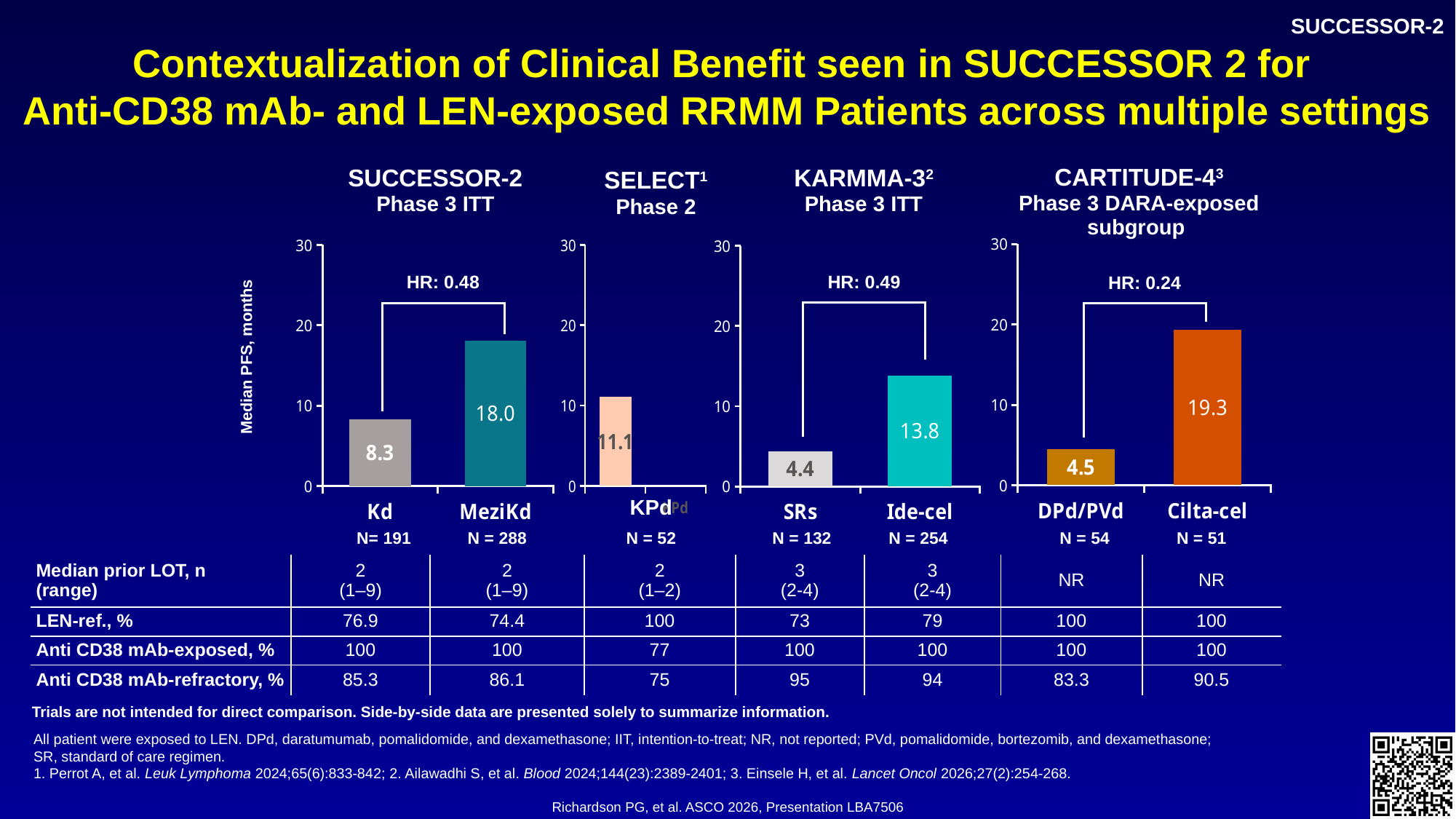
In the KARMMA-3 chart, what is the difference in median PFS between Ide-cel and SRs? 9.4 In the CARTITUDE-4 chart, what is the median PFS in months for Cilta-cel? 19.3 In the KARMMA-3 chart, which arm has the lowest median PFS? SRs How many bars are shown in the SELECT chart? 1 In the CARTITUDE-4 chart, which arm has the higher median PFS, DPd/PVd or Cilta-cel? Cilta-cel What type of chart is used to show median PFS in the SUCCESSOR-2 panel? Bar chart In the SUCCESSOR-2 chart, what is the difference in median PFS between MeziKd and Kd? 9.7 In the KARMMA-3 chart, what is the median PFS in months for Ide-cel? 13.8 In the SUCCESSOR-2 chart, what is the median PFS in months for MeziKd? 18.0 In the SUCCESSOR-2 chart, what is the median PFS in months for Kd? 8.3 What hazard ratio is shown above the bars in the CARTITUDE-4 chart? HR: 0.24 In the SELECT chart, what is the median PFS in months for KPd? 11.1